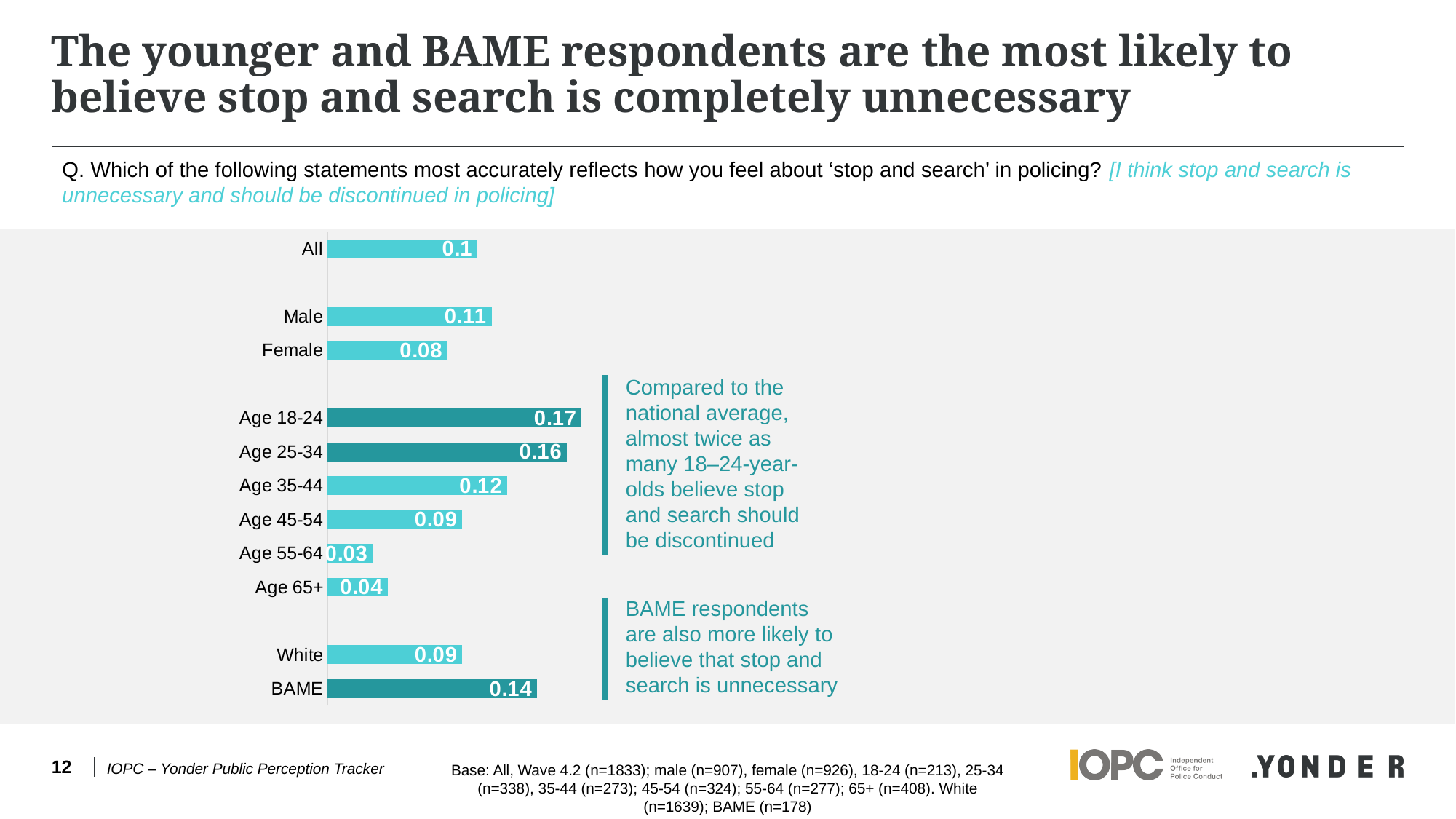
What kind of chart is shown on the slide? Bar chart Which category has the lowest value? Age 55-64 How many categories are plotted in the chart? 11 What is the value for Female? 0.08 Which is larger, the value for Male or the value for Female? Male What is the value for All? 0.1 Which category has the highest value? Age 18-24 What is the difference between the values for BAME and White? 0.05 What is the difference between the values for Age 18-24 and All? 0.07 What is the value for Age 18-24? 0.17 Do the values rise or fall across the age groups from Age 18-24 to Age 55-64? Fall What is the value for BAME respondents? 0.14